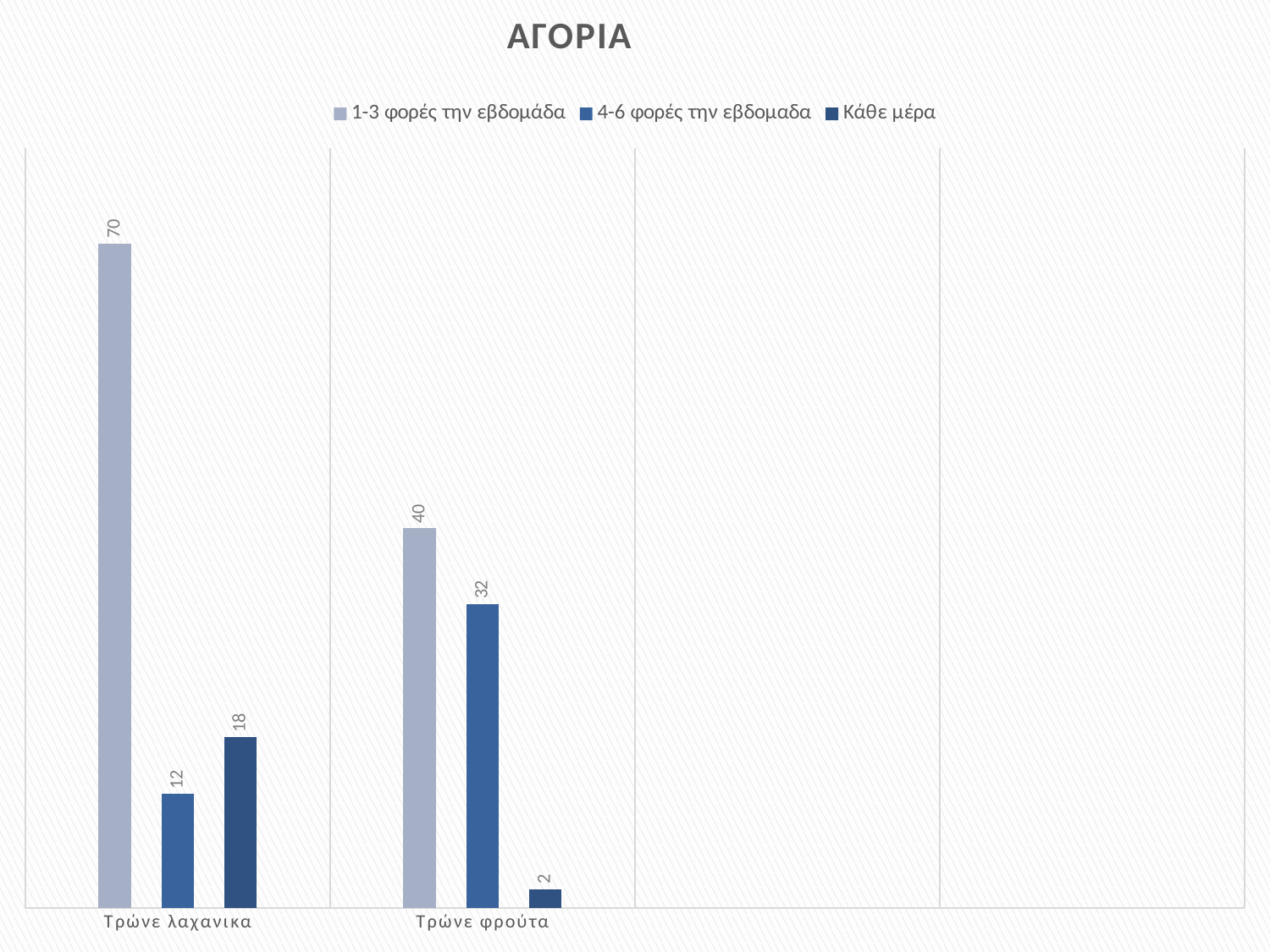
What is the value for 'Κάθε μέρα' in the 'Τρώνε φρούτα' category? 2 What is the value for '4-6 φορές την εβδομαδα' in the 'Τρώνε φρούτα' category? 32 What is the title of the chart? ΑΓΟΡΙΑ Which series has the lowest value in the 'Τρώνε φρούτα' category? Κάθε μέρα How many series does the legend list? 3 What is the value for '1-3 φορές την εβδομάδα' in the 'Τρώνε λαχανικα' category? 70 What kind of chart is shown on the slide? Bar chart Which is larger: the 'Κάθε μέρα' value for 'Τρώνε λαχανικα' or for 'Τρώνε φρούτα'? Τρώνε λαχανικα What is the value for 'Κάθε μέρα' in the 'Τρώνε λαχανικα' category? 18 Which series has the highest value in the 'Τρώνε λαχανικα' category? 1-3 φορές την εβδομάδα How many categories are shown on the x axis? 2 What is the difference between the '1-3 φορές την εβδομάδα' values for 'Τρώνε λαχανικα' and 'Τρώνε φρούτα'? 30